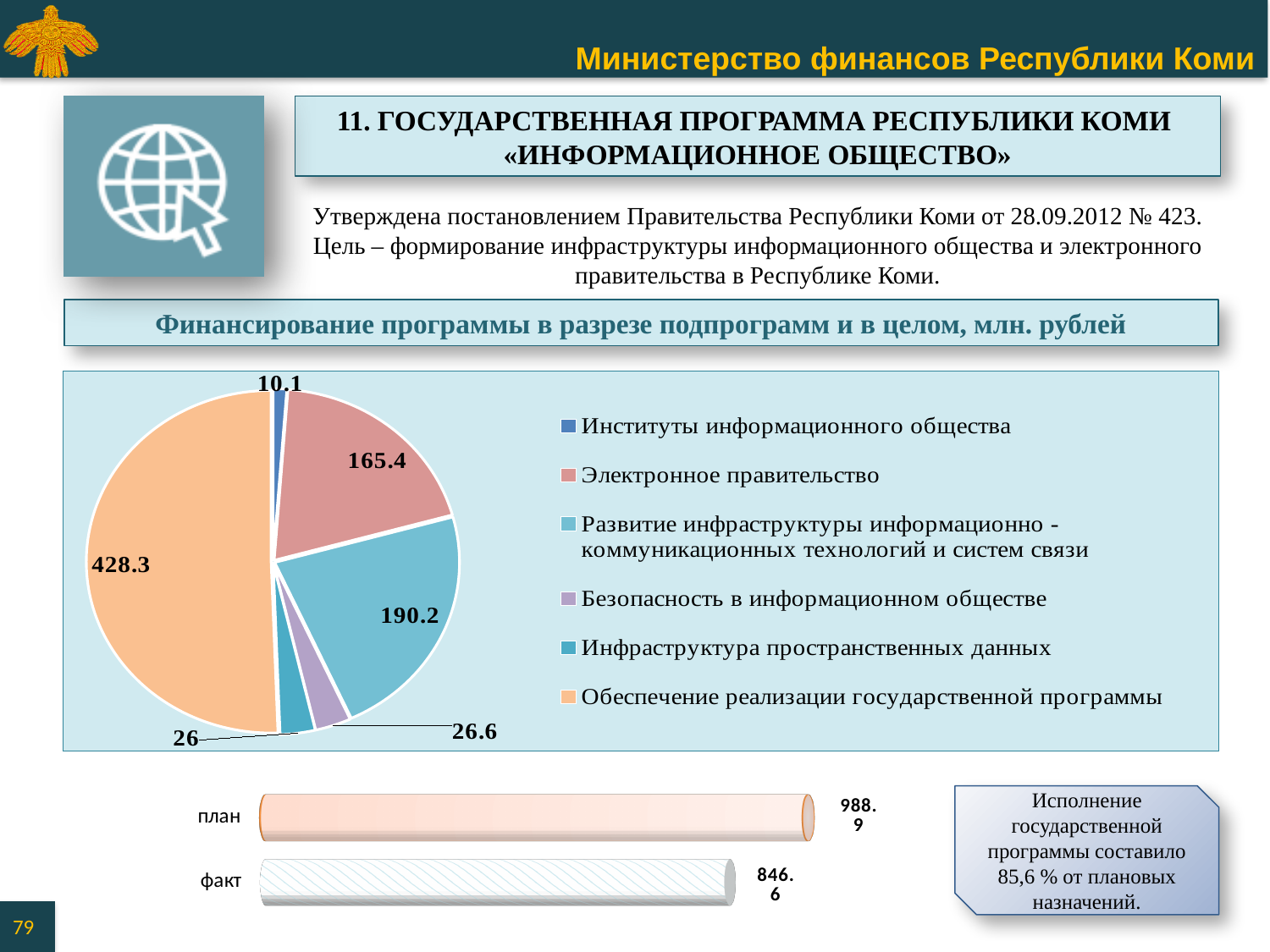
What kind of chart is the upper chart on the slide? pie chart What kind of chart is the lower chart on the slide (план/факт)? bar chart In the pie chart, which category has the largest value? Обеспечение реализации государственной программы In the lower bar chart, what is the value for «план»? 988.9 In the pie chart, what is the value for «Обеспечение реализации государственной программы»? 428.3 In the pie chart, what is the value for «Институты информационного общества»? 10.1 In the lower bar chart, what is the difference between «план» and «факт»? 142.3 In the pie chart, which is larger: «Электронное правительство» or «Развитие инфраструктуры информационно-коммуникационных технологий и систем связи»? Развитие инфраструктуры информационно-коммуникационных технологий и систем связи In the pie chart, what is the value for «Электронное правительство»? 165.4 How many categories does the pie chart's legend list? 6 In the pie chart, what is the difference between the values 190.2 and 165.4? 24.8 In the pie chart, which category has the smallest value? Институты информационного общества